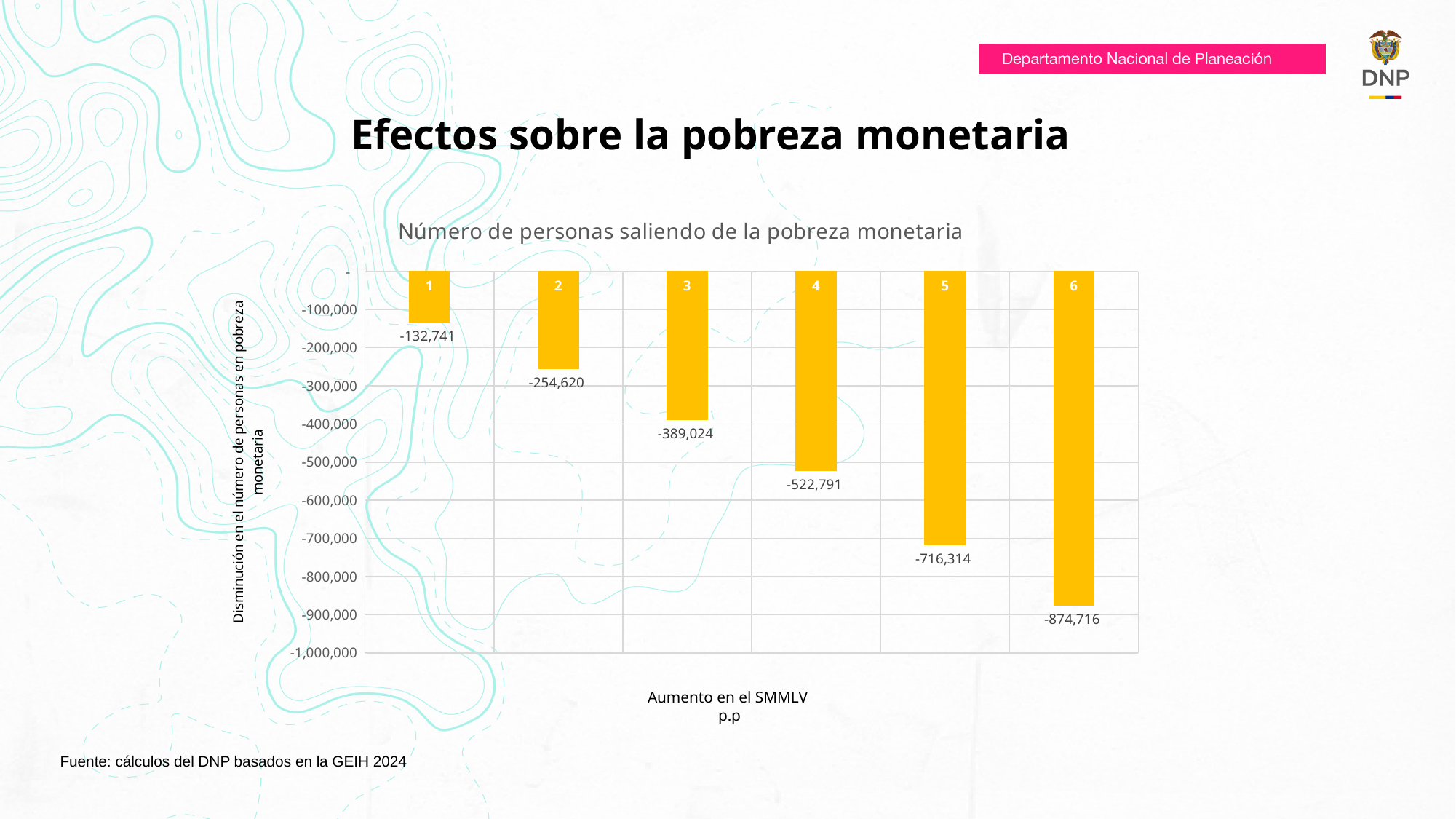
Which category has the lowest (most negative) value? 6 Which category has the smallest decrease in the number of people in poverty? 1 What kind of chart is shown on the slide? Bar chart What is the value shown for category 6? -874,716 What is the value shown for category 4? -522,791 How many categories are plotted on the chart? 6 What is the difference between the values for category 2 and category 1? 121,879 What is the value shown for category 1? -132,741 Is the value for category 3 greater or less than -400,000? greater Do the values rise or fall as the category number increases from 1 to 6? Fall Which category shows a larger decrease, 3 or 5? 5 What is the difference between the values for category 5 and category 4? 193,523